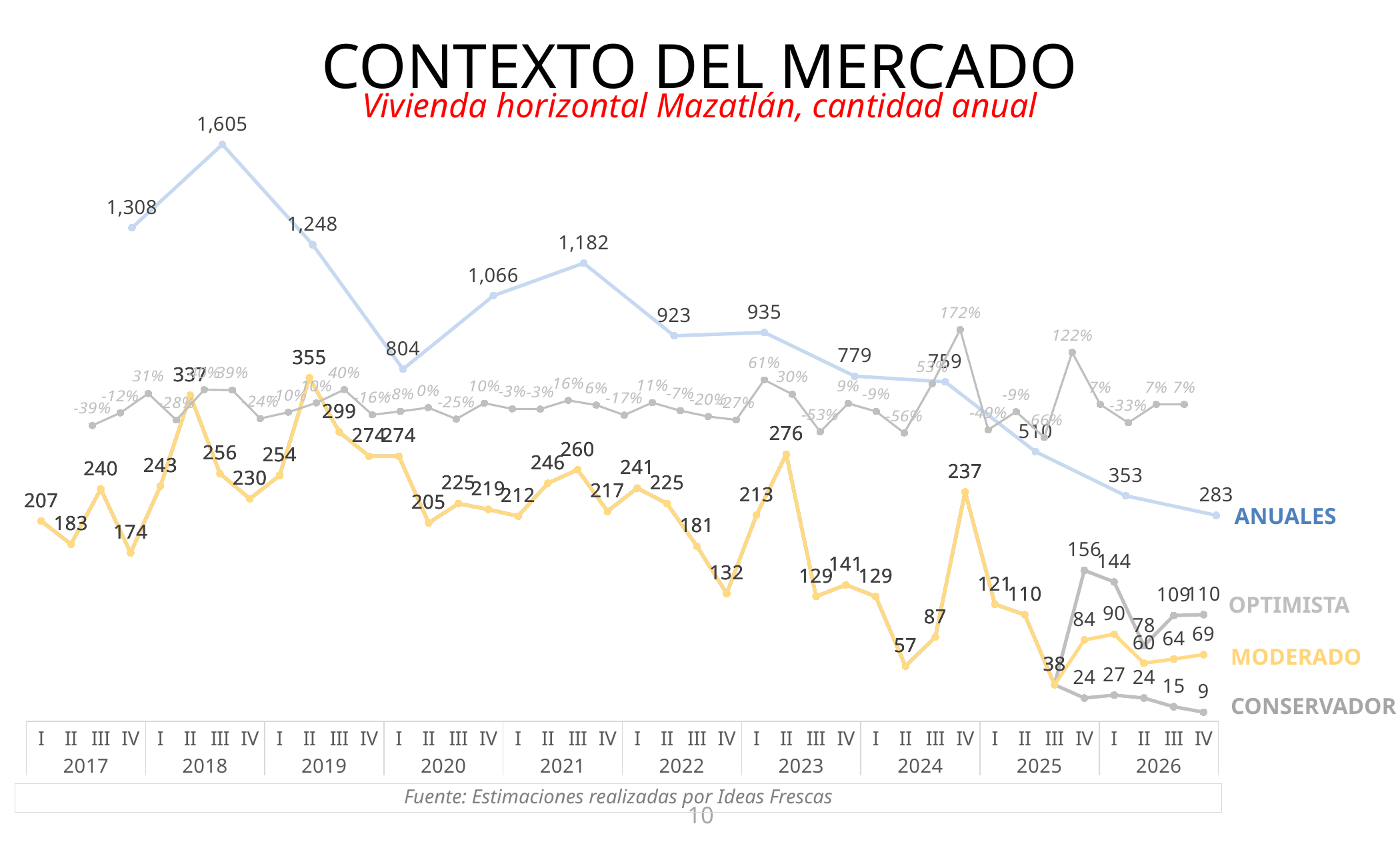
What is the value of the CONSERVADOR line in quarter IV of 2026? 9 What kind of chart is shown on the slide? line chart Does the ANUALES line rise or fall from 2022 to 2026? fall What source is cited below the chart? Estimaciones realizadas por Ideas Frescas How many years are shown on the x axis? 10 What is the difference between the highest ANUALES value (1,605) and the first ANUALES value (1,308)? 297 What is the lowest value labeled on the ANUALES line? 283 What is the highest value labeled on the ANUALES line? 1,605 Which is larger, the MODERADO value in quarter I of 2017 (207) or in quarter II of 2017 (183)? quarter I of 2017 What is the highest value labeled on the MODERADO line? 355 What is the lowest value labeled on the MODERADO line? 38 What is the value of the OPTIMISTA line in quarter IV of 2025? 156